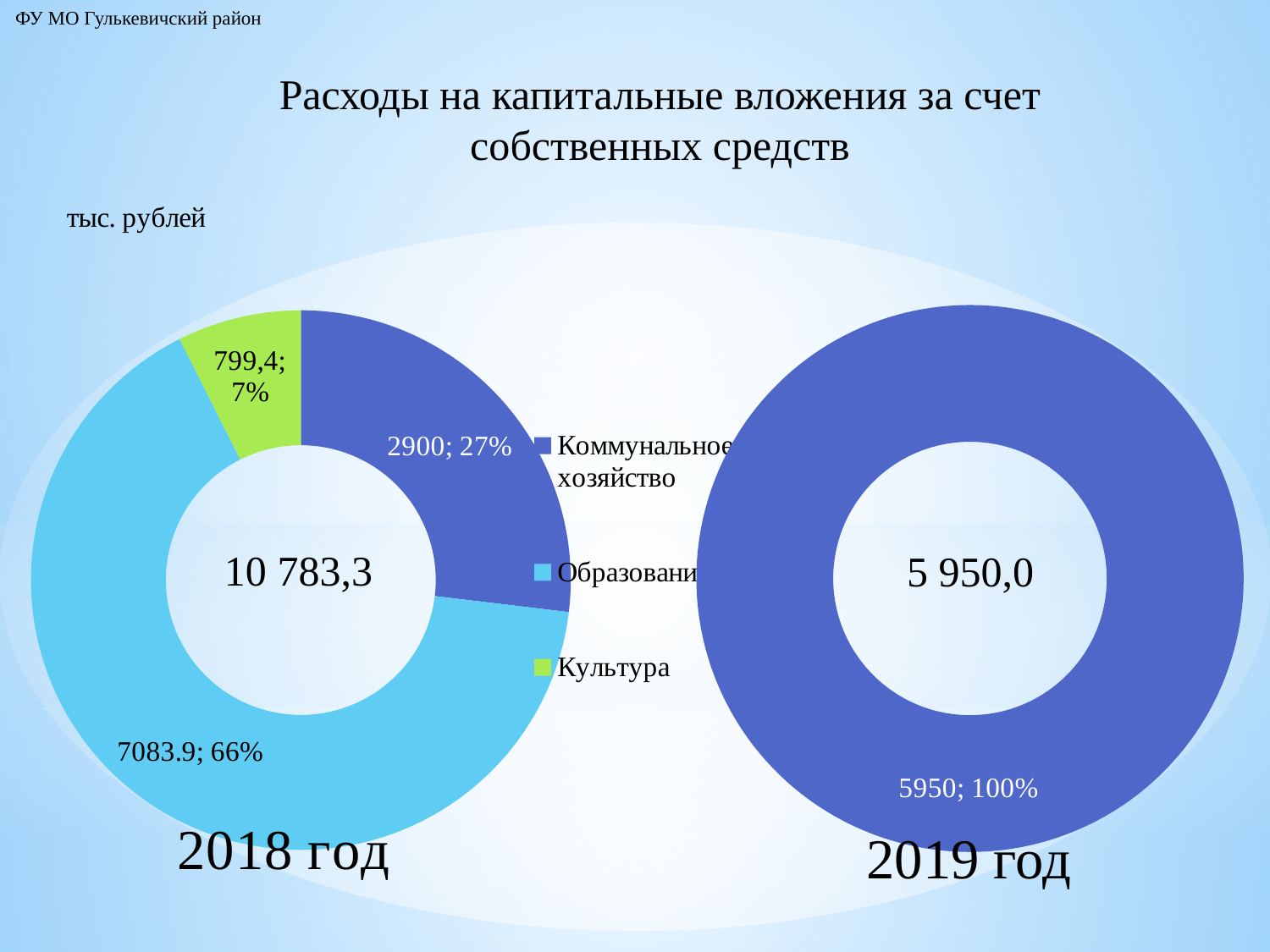
In the 2018 год chart, which category has the smallest slice? Культура How many categories does the legend list? 3 In the 2019 год chart, what value is shown for Коммунальное хозяйство? 5950 In the 2018 год chart, what share of the total does Образование represent? 66% In the 2018 год chart, which is larger: Коммунальное хозяйство or Культура? Коммунальное хозяйство In the 2018 год chart, what share of the total does Культура represent? 7% In the 2018 год chart, what value is shown for Коммунальное хозяйство? 2900 In the 2018 год chart, what value is shown for Образование? 7083.9 What kind of chart is the 2018 год chart? Doughnut chart In the 2018 год chart, what value is shown for Культура? 799,4 In the 2018 год chart, which category has the largest slice? Образование In the 2019 год chart, what share of the total does Коммунальное хозяйство represent? 100%